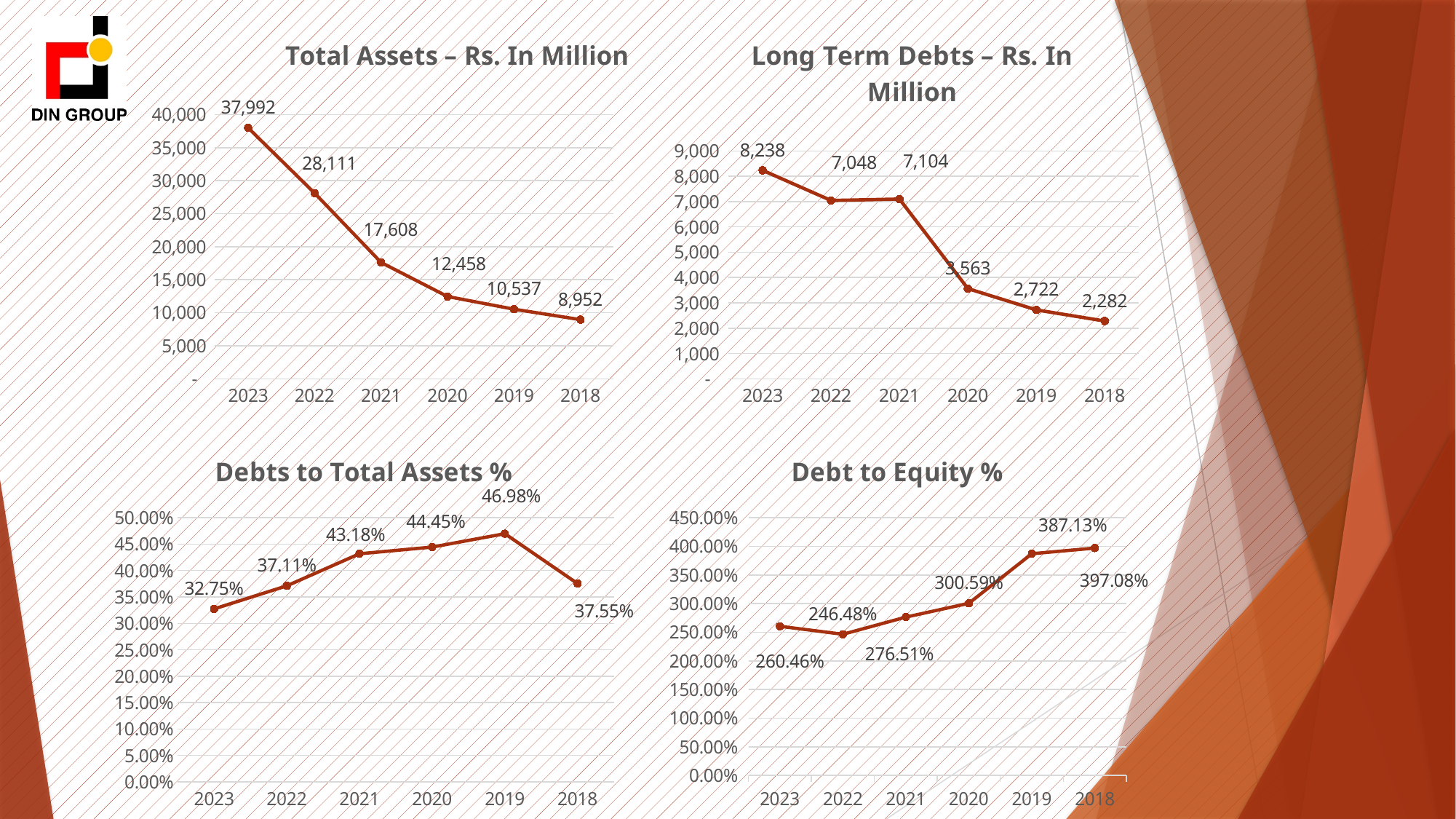
What type of chart is the Debts to Total Assets % chart? line chart In the Total Assets – Rs. In Million chart, what is the value for 2020? 12,458 In the Total Assets – Rs. In Million chart, what is the value for 2023? 37,992 In the Total Assets – Rs. In Million chart, do the values rise or fall moving from left to right along the x axis? fall In the Debts to Total Assets % chart, which year has the lowest value? 2023 In the Debt to Equity % chart, what is the value for 2021? 276.51% In the Debts to Total Assets % chart, which year has the highest value? 2019 In the Long Term Debts – Rs. In Million chart, what is the difference between the 2023 value and the 2018 value? 5,956 In the Long Term Debts – Rs. In Million chart, which year has the highest value? 2023 In the Debt to Equity % chart, is the value for 2019 larger or smaller than the value for 2020? larger In the Long Term Debts – Rs. In Million chart, what is the value for 2019? 2,722 How many years are plotted in the Debt to Equity % chart? 6